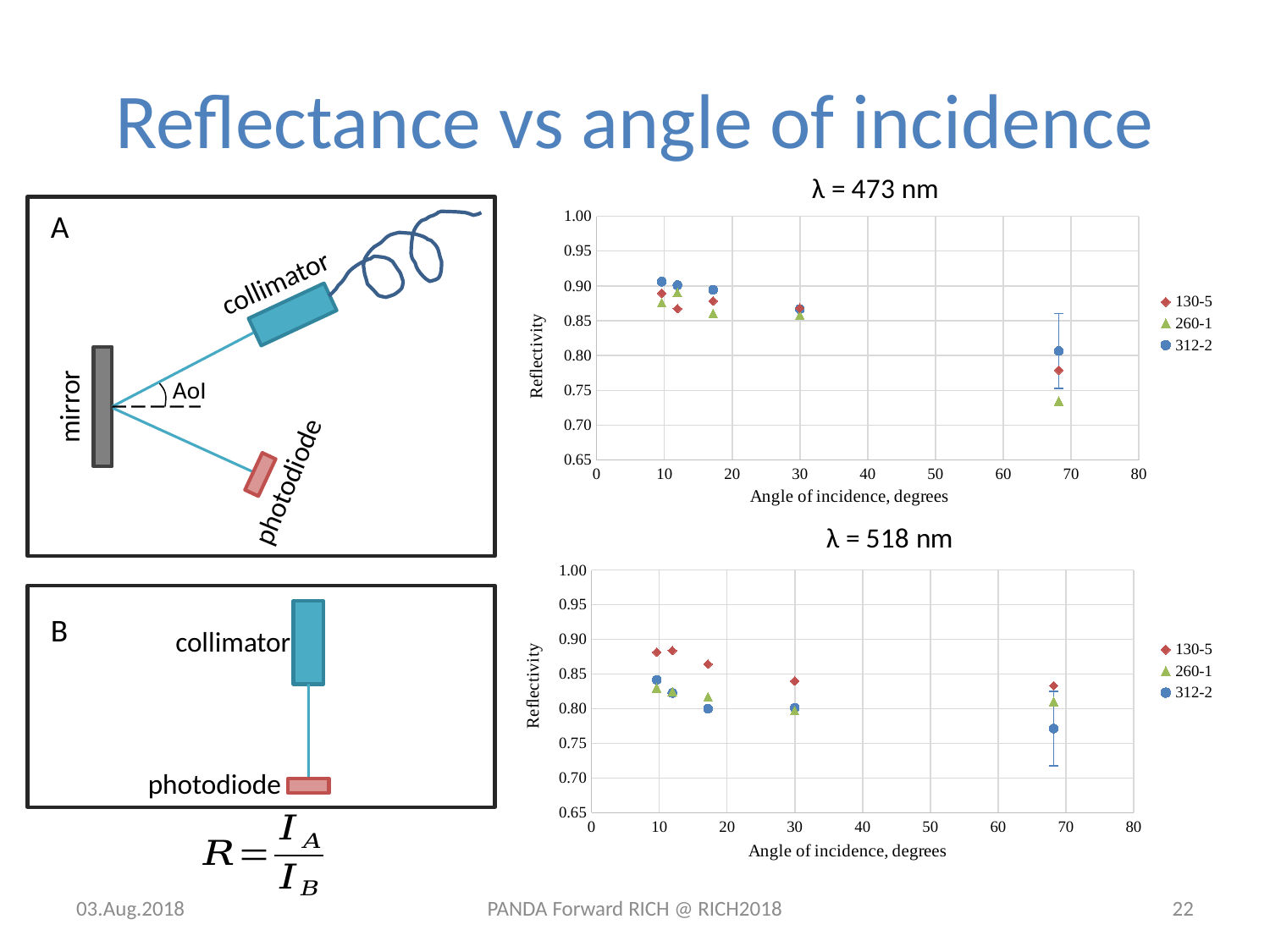
In the λ = 473 nm chart, is the reflectivity of series 260-1 at about 68 degrees greater or less than 0.80? less In the λ = 518 nm chart, does the reflectivity of series 130-5 generally rise or fall as the angle of incidence increases? fall In the λ = 518 nm chart, is the reflectivity of series 312-2 at about 68 degrees greater or less than 0.80? less In the λ = 518 nm chart, is the reflectivity of series 130-5 at about 10 degrees greater or less than 0.85? greater In the λ = 518 nm chart, which series has the lowest reflectivity at the largest angle of incidence (around 68 degrees)? 312-2 In the λ = 518 nm chart, which series has the highest reflectivity at the smallest angles of incidence (around 10 degrees)? 130-5 In the λ = 473 nm chart, which series has the lowest reflectivity at the largest angle of incidence (around 68 degrees)? 260-1 How many series does the legend of the λ = 518 nm chart list? 3 In the λ = 473 nm chart, which series has the highest reflectivity at the largest angle of incidence (around 68 degrees)? 312-2 What kind of chart is the λ = 473 nm chart? scatter chart What is the label of the y axis on the λ = 473 nm chart? Reflectivity